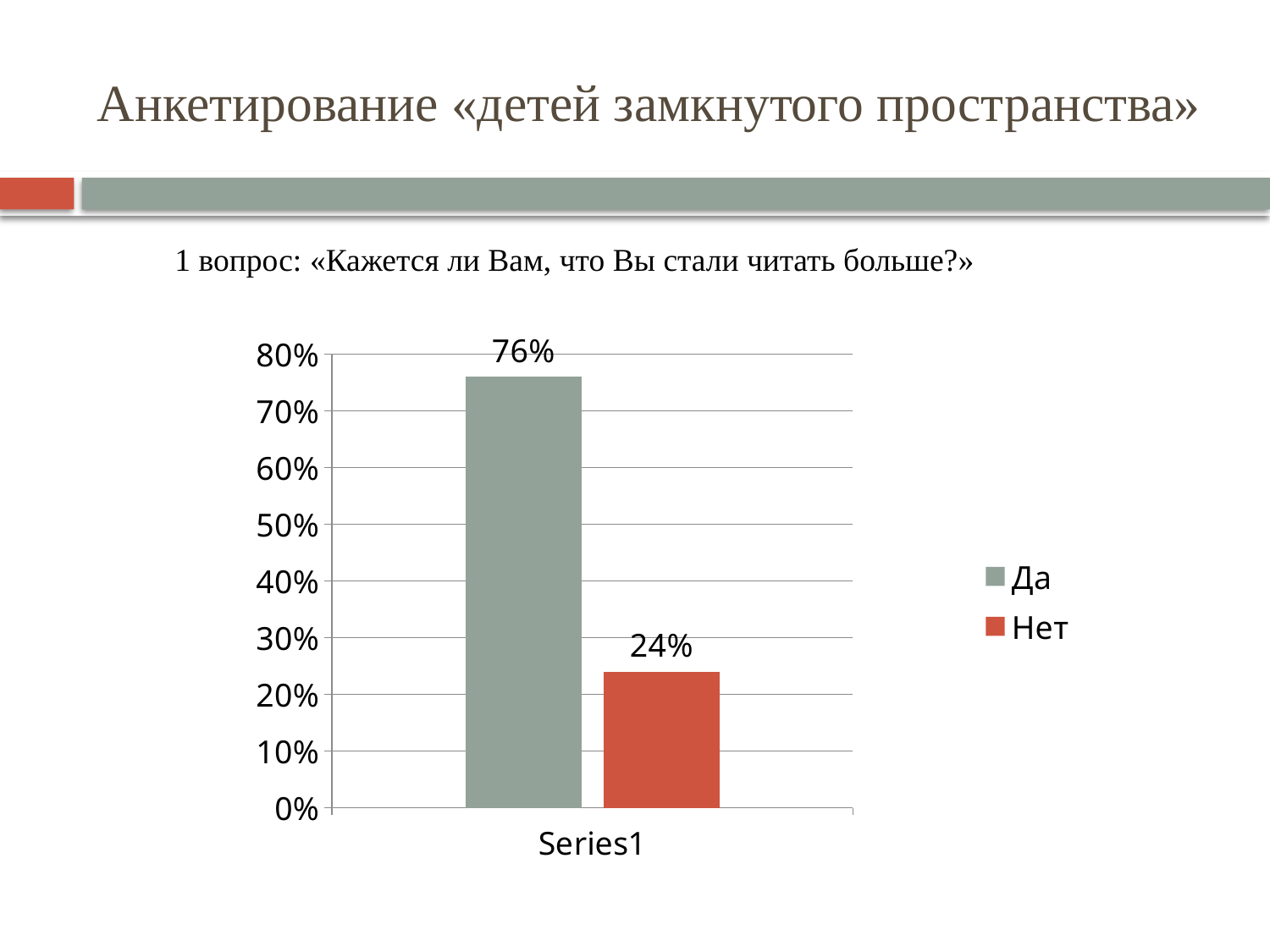
How many series does the legend list? 2 Is the value for Нет greater or less than 30%? less Which is larger, the value for Да or the value for Нет? Да What is the difference between the values for Да and Нет? 52% Which answer has the lowest value? Нет What kind of chart is shown on the slide? bar chart What colour is the bar for Нет? red What is the value for Да? 76% What is the value for Нет? 24% What is the category label shown on the x axis? Series1 Which answer has the highest value? Да Is the value for Да greater or less than 70%? greater